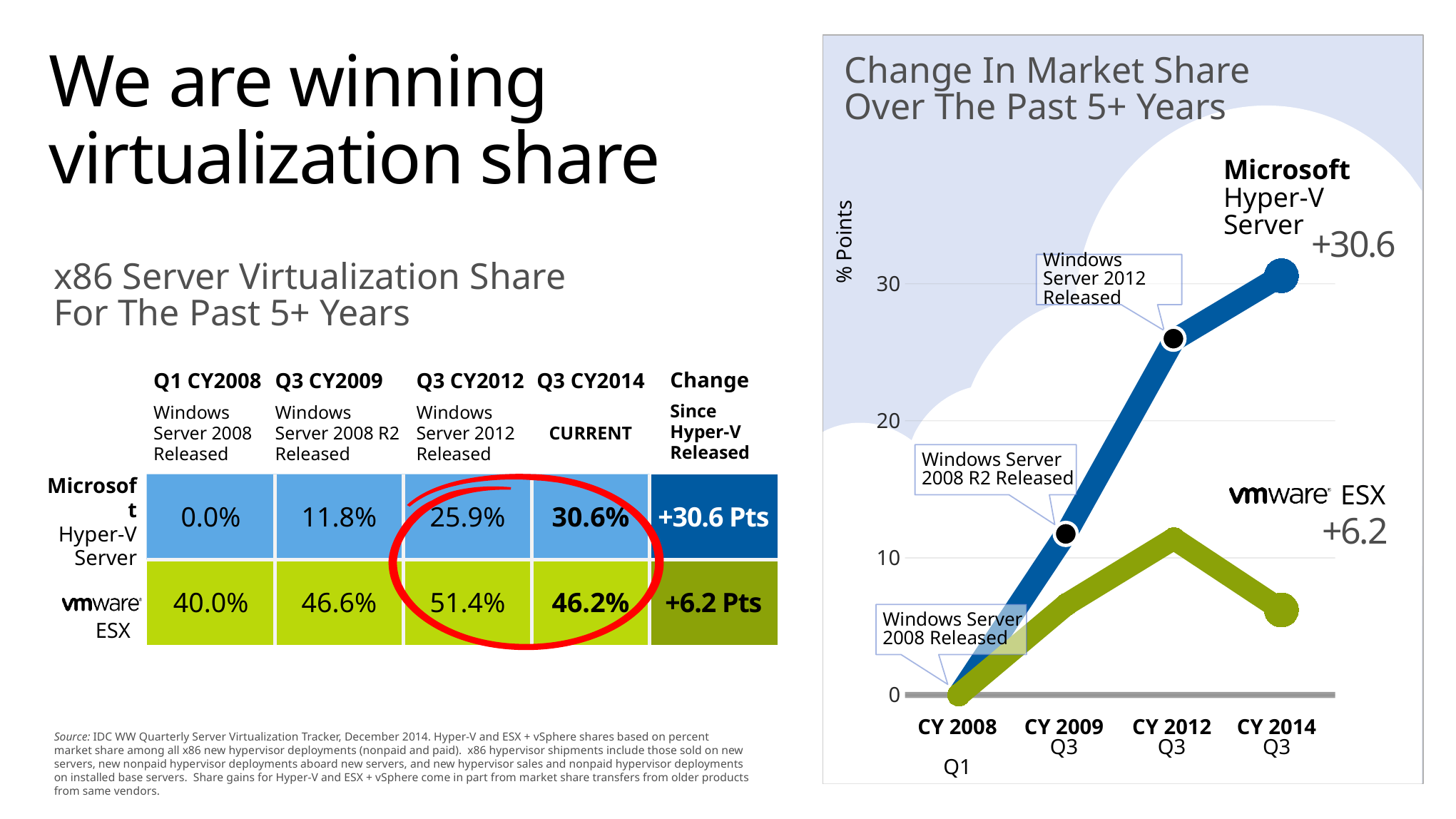
In the 'Change In Market Share Over The Past 5+ Years' chart, is the Microsoft Hyper-V Server value at CY 2012 Q3 greater or less than 20? greater In the 'Change In Market Share Over The Past 5+ Years' chart, is the VMware ESX value at CY 2009 Q3 greater or less than 10? less What is the label on the vertical axis of the 'Change In Market Share Over The Past 5+ Years' chart? % Points How many series are plotted in the 'Change In Market Share Over The Past 5+ Years' chart? 2 In the 'Change In Market Share Over The Past 5+ Years' chart, does the Microsoft Hyper-V Server line rise or fall from CY 2008 to CY 2014? rise In the 'Change In Market Share Over The Past 5+ Years' chart, what value is labelled for Microsoft Hyper-V Server at CY 2014 Q3? +30.6 In the 'Change In Market Share Over The Past 5+ Years' chart, what is the difference between the labelled CY 2014 values for Microsoft Hyper-V Server and VMware ESX? 24.4 What kind of chart is shown on the right side of the slide? line chart What is the title of the chart on the right side of the slide? Change In Market Share Over The Past 5+ Years How many time points are plotted along the x axis of the 'Change In Market Share Over The Past 5+ Years' chart? 4 In the 'Change In Market Share Over The Past 5+ Years' chart, which series has the higher value at CY 2014 Q3? Microsoft Hyper-V Server In the 'Change In Market Share Over The Past 5+ Years' chart, what value is labelled for VMware ESX at CY 2014 Q3? +6.2